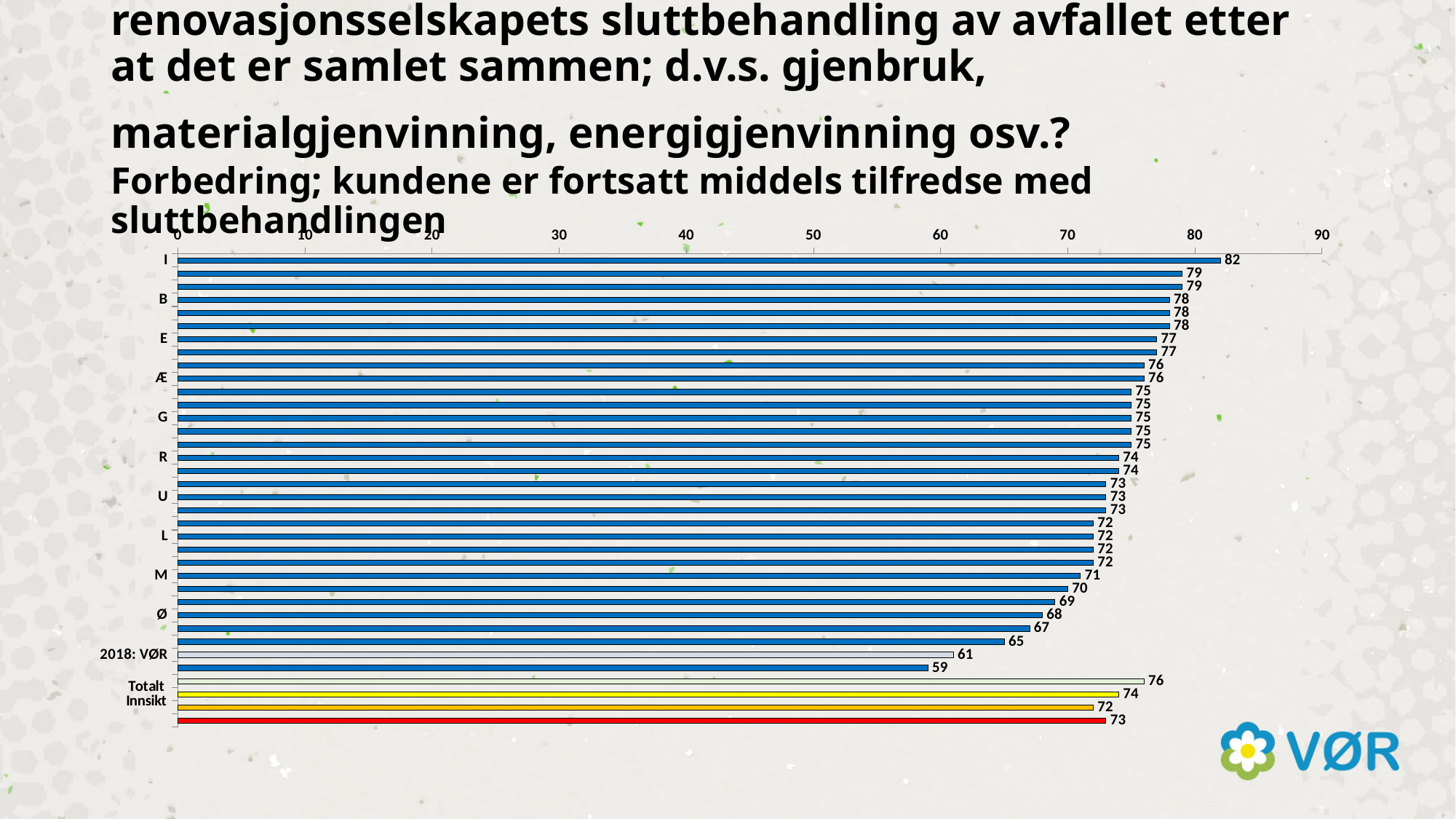
What kind of chart is shown on the slide? bar chart Is the value for Ø greater or less than 70? less What is the value for category Ø? 68 What is the value for 2018: VØR? 61 What is the difference between the value for B and the value for Ø? 10 What is the value for category I? 82 What is the value for category B? 78 What is the value for category M? 71 What is the difference between the value for I and the value for 2018: VØR? 21 What colour is the bottom bar of the chart? red Which has the larger value, E or M? E Which labelled category has the highest value? I